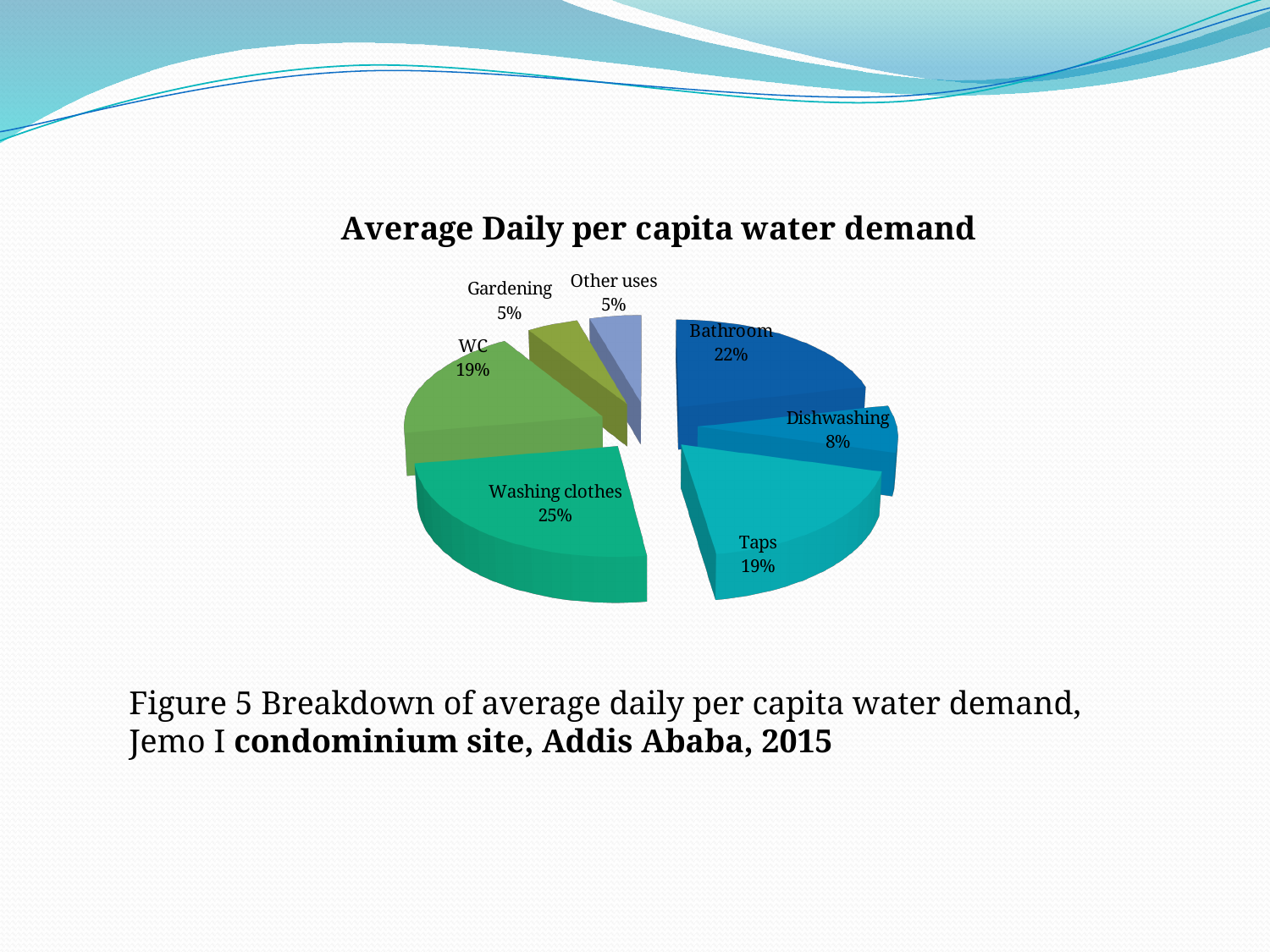
What kind of chart is shown on the slide? Pie chart What is the difference between the shares for Washing clothes and Taps? 6% How many categories are shown in the pie chart? 7 What is the difference between the shares for Bathroom and Dishwashing? 14% What share of the pie does Bathroom account for? 22% What is the value shown for Washing clothes? 25% What is the value shown for Taps? 19% Which category has the largest share of the pie? Washing clothes Which is larger, the share for WC or the share for Gardening? WC What is the title of the chart? Average Daily per capita water demand Which two categories each have a share of 5%? Gardening and Other uses What is the value shown for Dishwashing? 8%